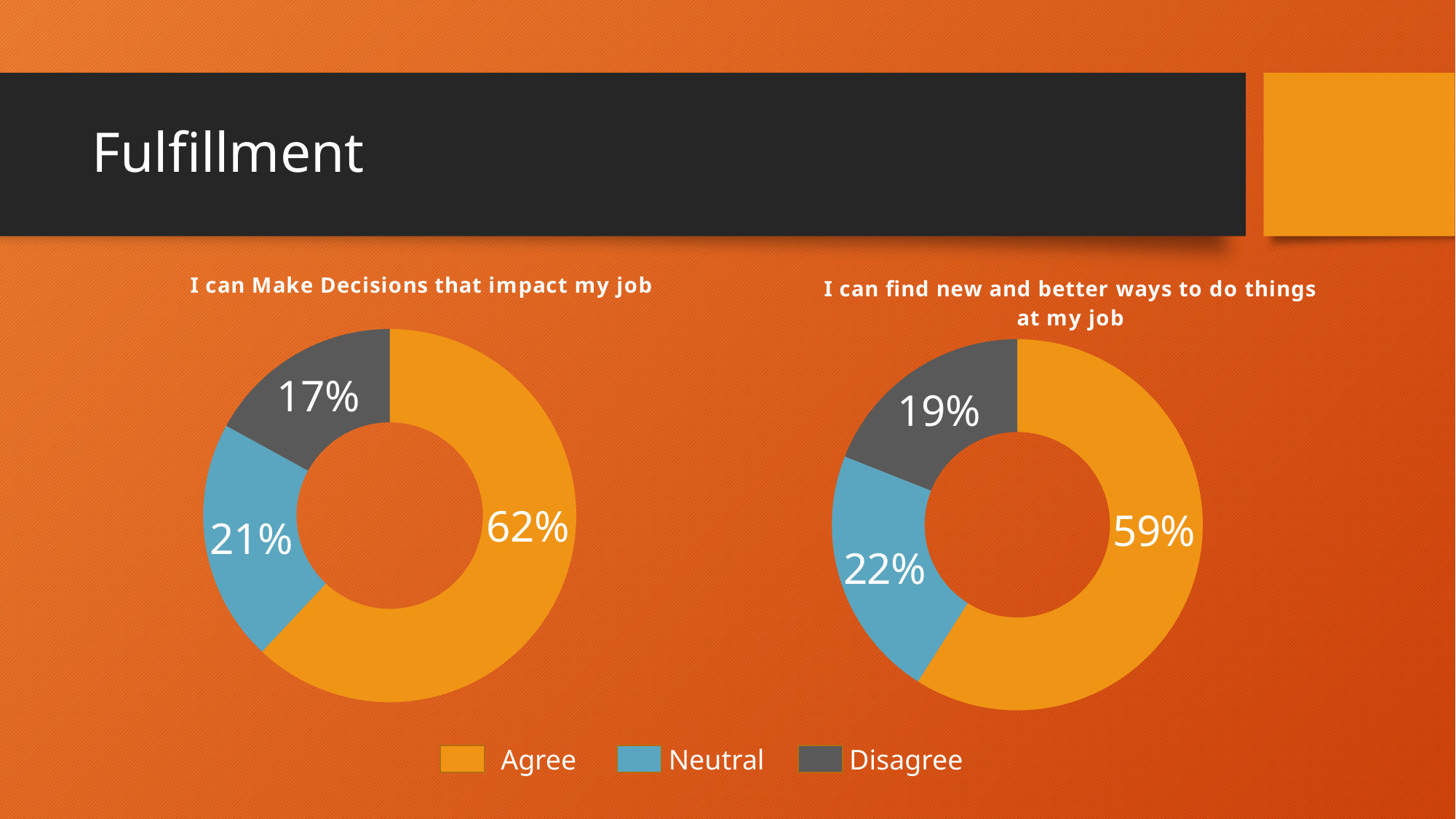
In the chart titled 'I can find new and better ways to do things at my job', what percentage of respondents Agree? 59% What kind of chart is used for 'I can Make Decisions that impact my job'? Doughnut chart In the chart titled 'I can find new and better ways to do things at my job', what is the difference in percentage points between Neutral and Disagree? 3 In the chart titled 'I can Make Decisions that impact my job', what percentage of respondents are Neutral? 21% In the chart titled 'I can Make Decisions that impact my job', what is the difference in percentage points between Agree and Disagree? 45 In the chart titled 'I can find new and better ways to do things at my job', what percentage of respondents Disagree? 19% What colour represents Neutral in the legend? Blue How many response categories does each chart on the slide show? 3 In the chart titled 'I can Make Decisions that impact my job', what percentage of respondents Agree? 62% In the chart titled 'I can find new and better ways to do things at my job', which response has the largest share? Agree In the chart titled 'I can Make Decisions that impact my job', which response has the smallest share? Disagree Which chart has the larger Agree share: 'I can Make Decisions that impact my job' or 'I can find new and better ways to do things at my job'? I can Make Decisions that impact my job